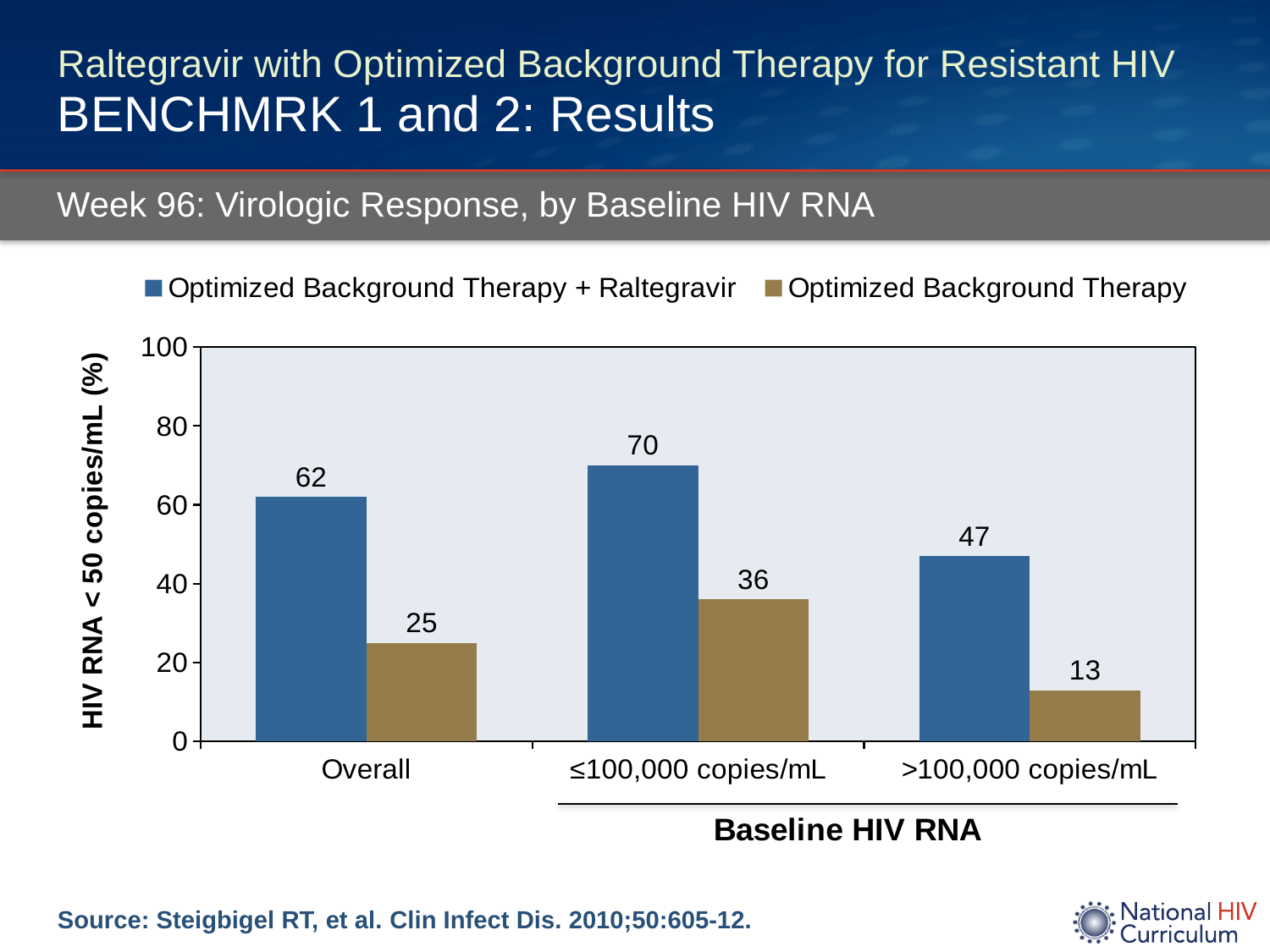
What is the value for Optimized Background Therapy in the >100,000 copies/mL category? 13 What is the value for Optimized Background Therapy in the ≤100,000 copies/mL category? 36 What kind of chart is shown on the slide? Bar chart Which is larger: the Optimized Background Therapy value for ≤100,000 copies/mL or the Optimized Background Therapy value for Overall? ≤100,000 copies/mL Which category has the highest value for Optimized Background Therapy + Raltegravir? ≤100,000 copies/mL What is the difference between the two series in the >100,000 copies/mL category? 34 How many series does the legend list? 2 Which category has the lowest value for Optimized Background Therapy? >100,000 copies/mL What is the value for Optimized Background Therapy + Raltegravir in the Overall category? 62 What is the difference between the Optimized Background Therapy + Raltegravir values for ≤100,000 copies/mL and >100,000 copies/mL? 23 What is the label of the y axis? HIV RNA < 50 copies/mL (%) How many categories are shown on the x axis? 3